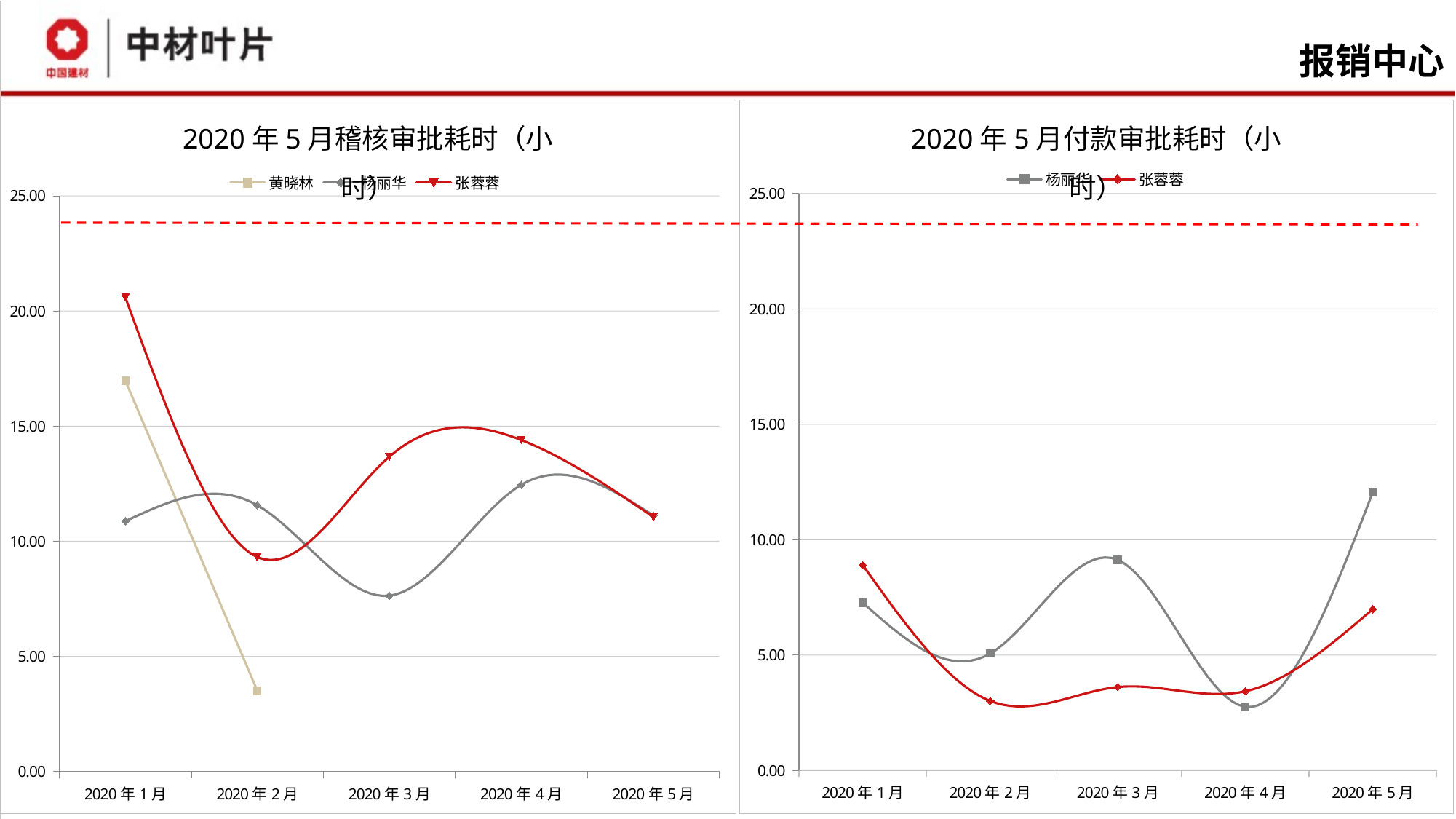
In the right chart (2020年5月付款审批耗时), is the value for 杨丽华 in 2020年5月 greater or less than 10.00? greater In the left chart (2020年5月稽核审批耗时), which is larger in 2020年3月, 张蓉蓉 or 杨丽华? 张蓉蓉 How many series does the legend of the right chart (2020年5月付款审批耗时) list? 2 In the left chart (2020年5月稽核审批耗时), is the value for 张蓉蓉 in 2020年1月 greater or less than 20.00? greater How many months are shown on the x axis of the right chart (2020年5月付款审批耗时)? 5 In the left chart (2020年5月稽核审批耗时), which series has the highest value in 2020年1月? 张蓉蓉 What kind of chart is the left chart titled 2020年5月稽核审批耗时（小时）? line chart How many series does the legend of the left chart (2020年5月稽核审批耗时) list? 3 In the right chart (2020年5月付款审批耗时), in which month is the value for 杨丽华 lowest? 2020年4月 In the left chart (2020年5月稽核审批耗时), is the value for 黄晓林 in 2020年2月 greater or less than 5.00? less In the left chart (2020年5月稽核审批耗时), does the 黄晓林 line rise or fall from 2020年1月 to 2020年2月? fall